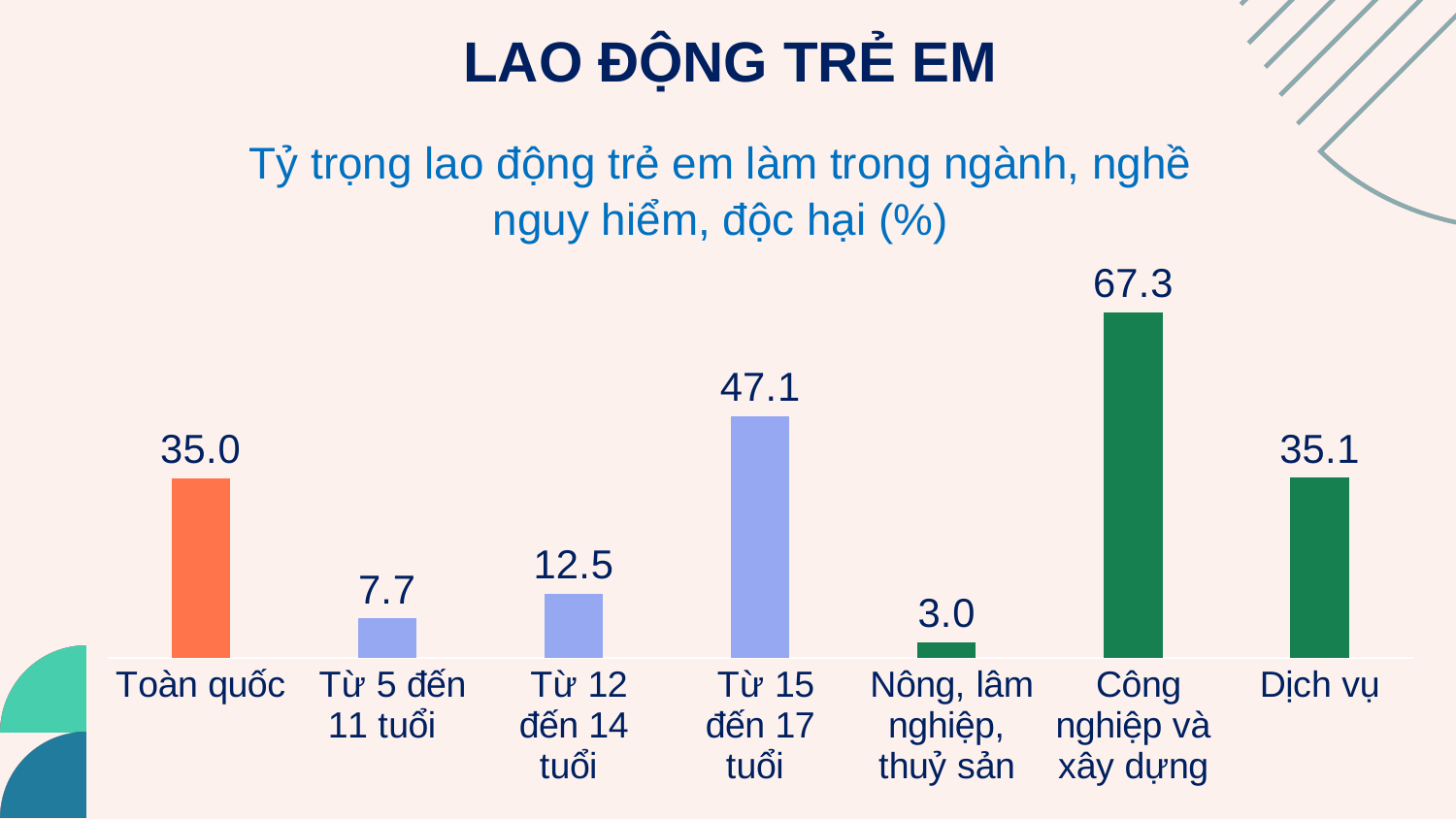
What is the value for "Công nghiệp và xây dựng"? 67.3 What is the difference between the values for "Công nghiệp và xây dựng" and "Dịch vụ"? 32.2 Which category has the highest value? Công nghiệp và xây dựng How many categories are shown in the chart? 7 Which category has the lowest value? Nông, lâm nghiệp, thuỷ sản What is the value for "Từ 5 đến 11 tuổi"? 7.7 What is the value for "Nông, lâm nghiệp, thuỷ sản"? 3.0 What is the title of the chart? Tỷ trọng lao động trẻ em làm trong ngành, nghề nguy hiểm, độc hại (%) Which is larger, the value for "Từ 15 đến 17 tuổi" or the value for "Toàn quốc"? Từ 15 đến 17 tuổi What is the difference between the values for "Từ 15 đến 17 tuổi" and "Từ 12 đến 14 tuổi"? 34.6 What is the value for "Toàn quốc"? 35.0 What kind of chart is shown on the slide? Bar chart